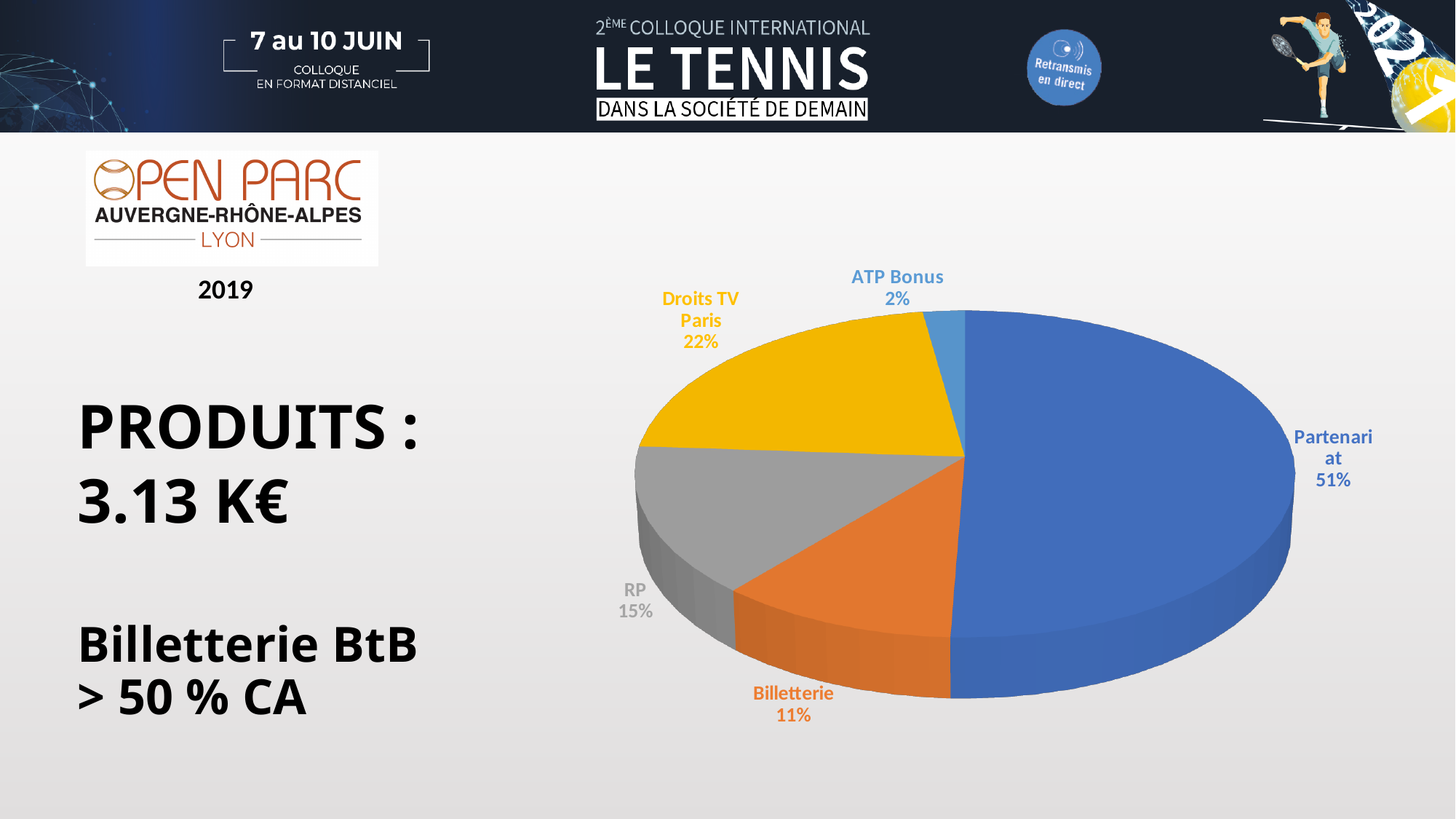
Which category has the largest share of the pie? Partenariat What share of the pie does Billetterie represent? 11% What share of the pie does ATP Bonus represent? 2% What share of the pie does Partenariat represent? 51% What kind of chart is shown on the slide? Pie chart Which category has the smallest share of the pie? ATP Bonus What is the difference in percentage points between Partenariat and Droits TV Paris? 29 How many categories are shown in the pie chart? 5 Which is larger, the share for RP or the share for Billetterie? RP What colour is the Droits TV Paris slice? Yellow